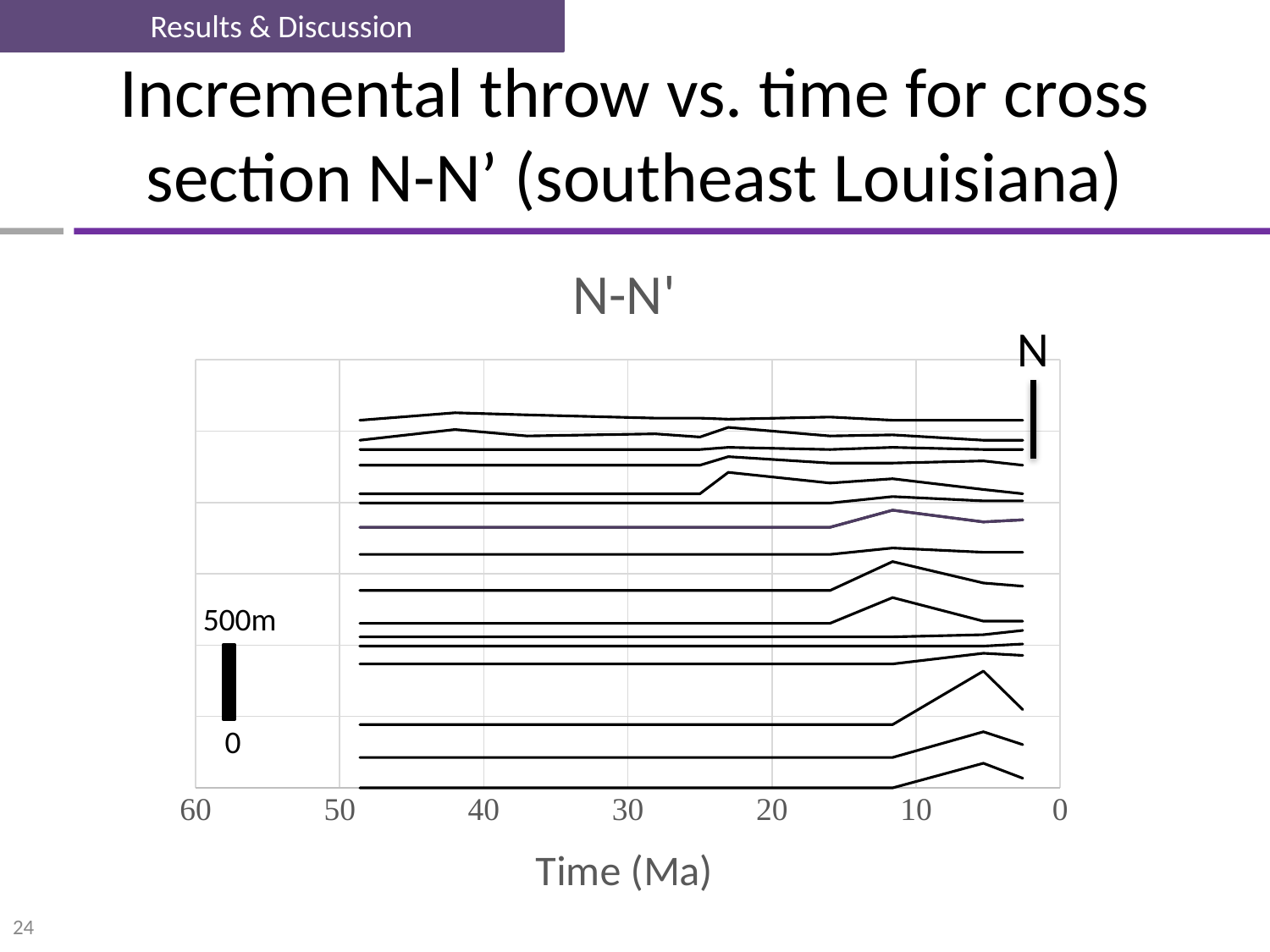
What kind of chart is shown on the slide? line chart What is the title of the chart? N-N' Do the x-axis values increase or decrease from left to right on the chart? decrease How many tick labels are shown along the x axis of the chart? 7 What is the label of the x axis of the chart? Time (Ma) What is the rightmost value shown on the x axis of the chart? 0 What length does the vertical scale bar to the left of the chart represent? 500m What is the leftmost value shown on the x axis of the chart? 60